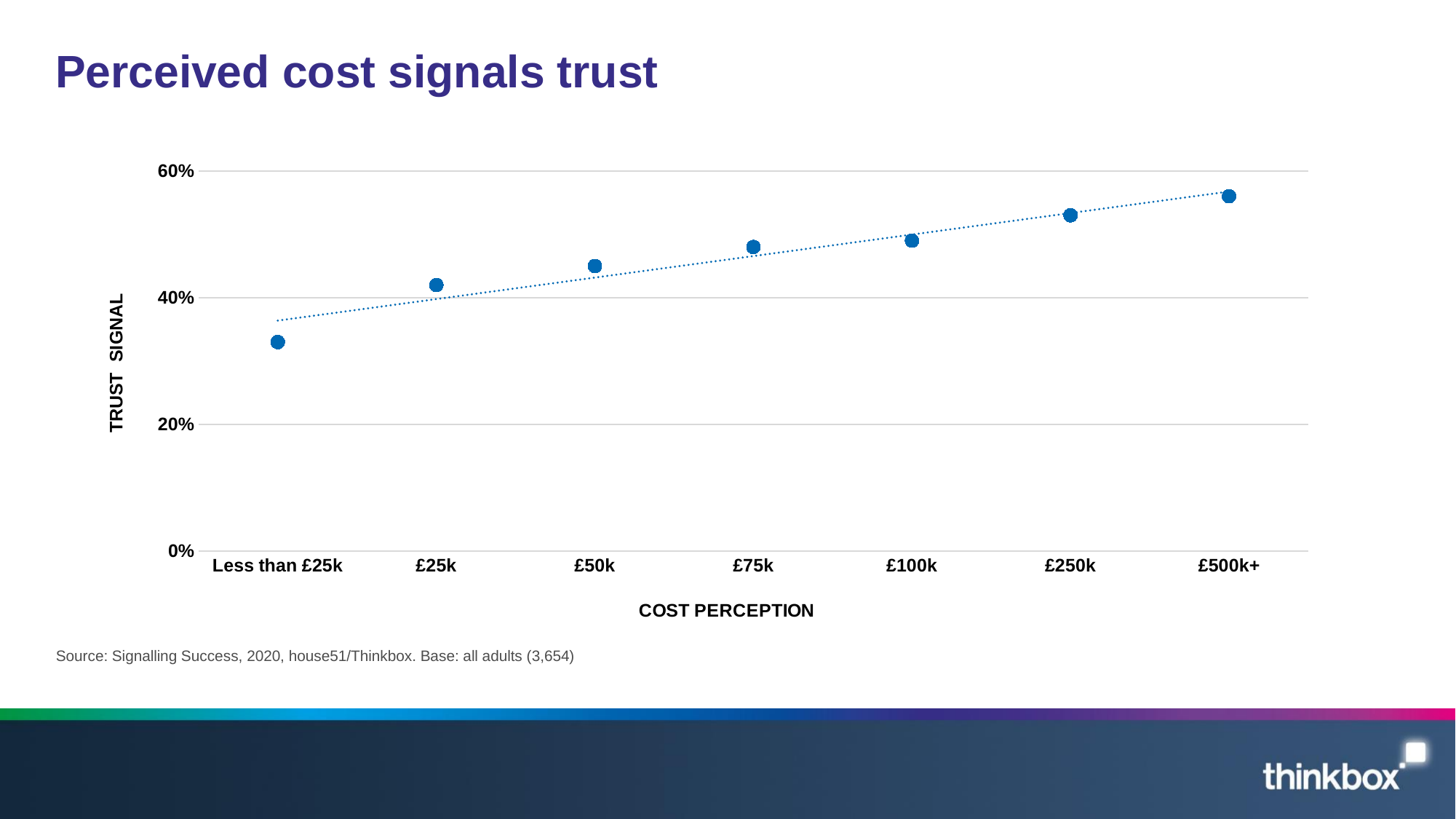
What is the title of the slide? Perceived cost signals trust Is the trust signal for £250k greater or less than 40%? greater Which has a higher trust signal, £50k or £250k? £250k Is the trust signal for £500k+ greater or less than 60%? less Do the trust signal values rise or fall as cost perception increases along the x axis? Rise Which cost perception category has the highest trust signal? £500k+ Is the trust signal for £25k greater or less than 40%? greater How many cost perception categories are plotted on the x axis? 7 Which cost perception category has the lowest trust signal? Less than £25k What kind of chart is shown on the slide? Scatter chart What is the label of the y axis? TRUST SIGNAL